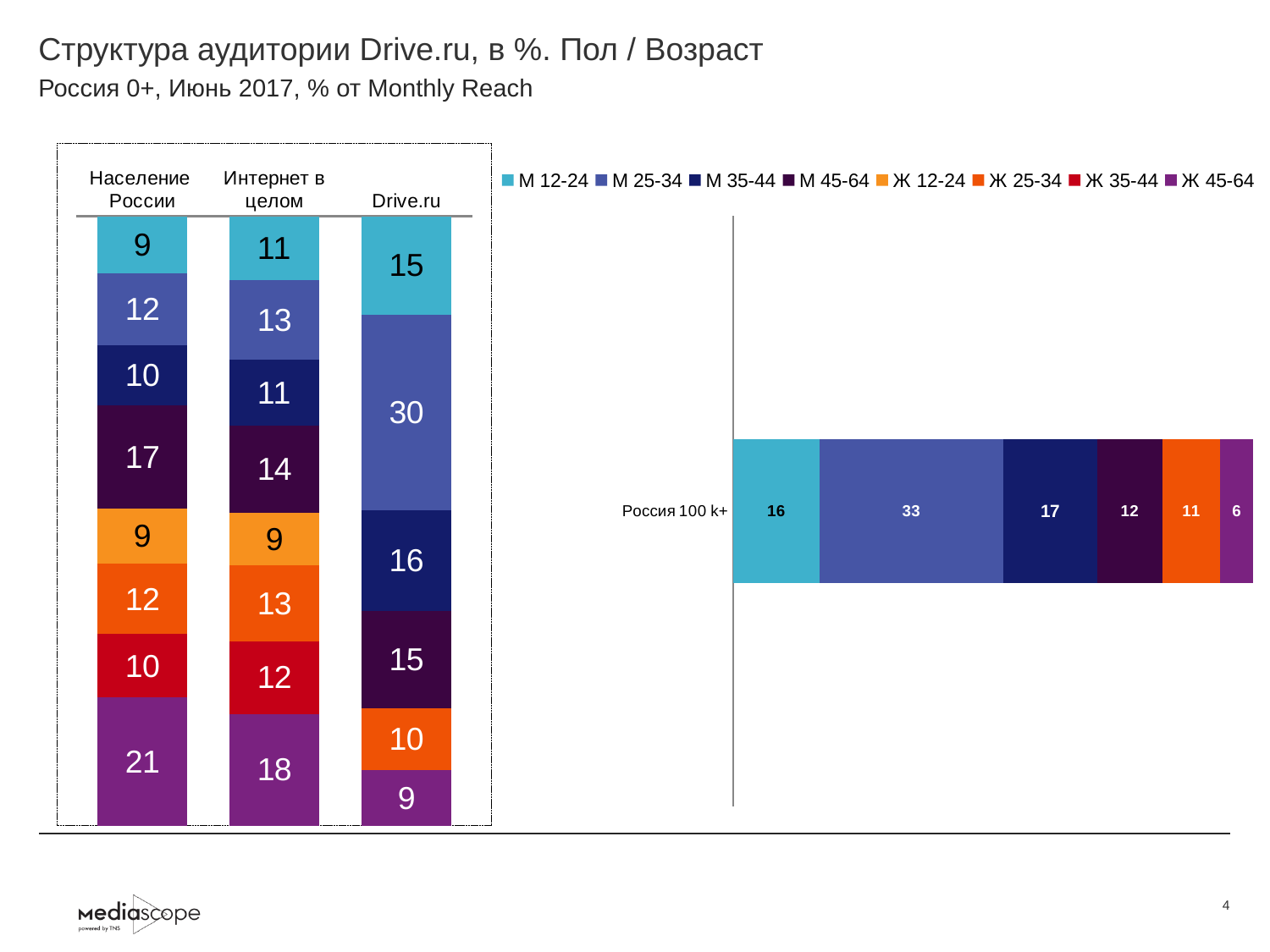
How many series does the legend list? 8 In the left stacked bar chart, what is the difference between the М 25-34 values for Drive.ru and Население России? 18 In the left stacked bar chart, what is the value of the М 45-64 segment for Интернет в целом? 14 What type of chart is used on the right side of the slide? Stacked bar chart In the left stacked bar chart, which segment of the Drive.ru bar is the largest? М 25-34 How many bars are shown in the left stacked bar chart? 3 In the right horizontal bar chart for Россия 100 k+, what is the value of the М 25-34 segment? 33 In the left stacked bar chart, what is the value of the М 25-34 segment for Drive.ru? 30 In the right horizontal bar chart for Россия 100 k+, which segment has the smallest value? Ж 45-64 In the left stacked bar chart, what is the value of the Ж 45-64 segment for Население России? 21 What is the total of the Россия 100 k+ bar in the right chart? 95 In the left stacked bar chart, which is larger: the Ж 45-64 value for Население России or for Интернет в целом? Население России